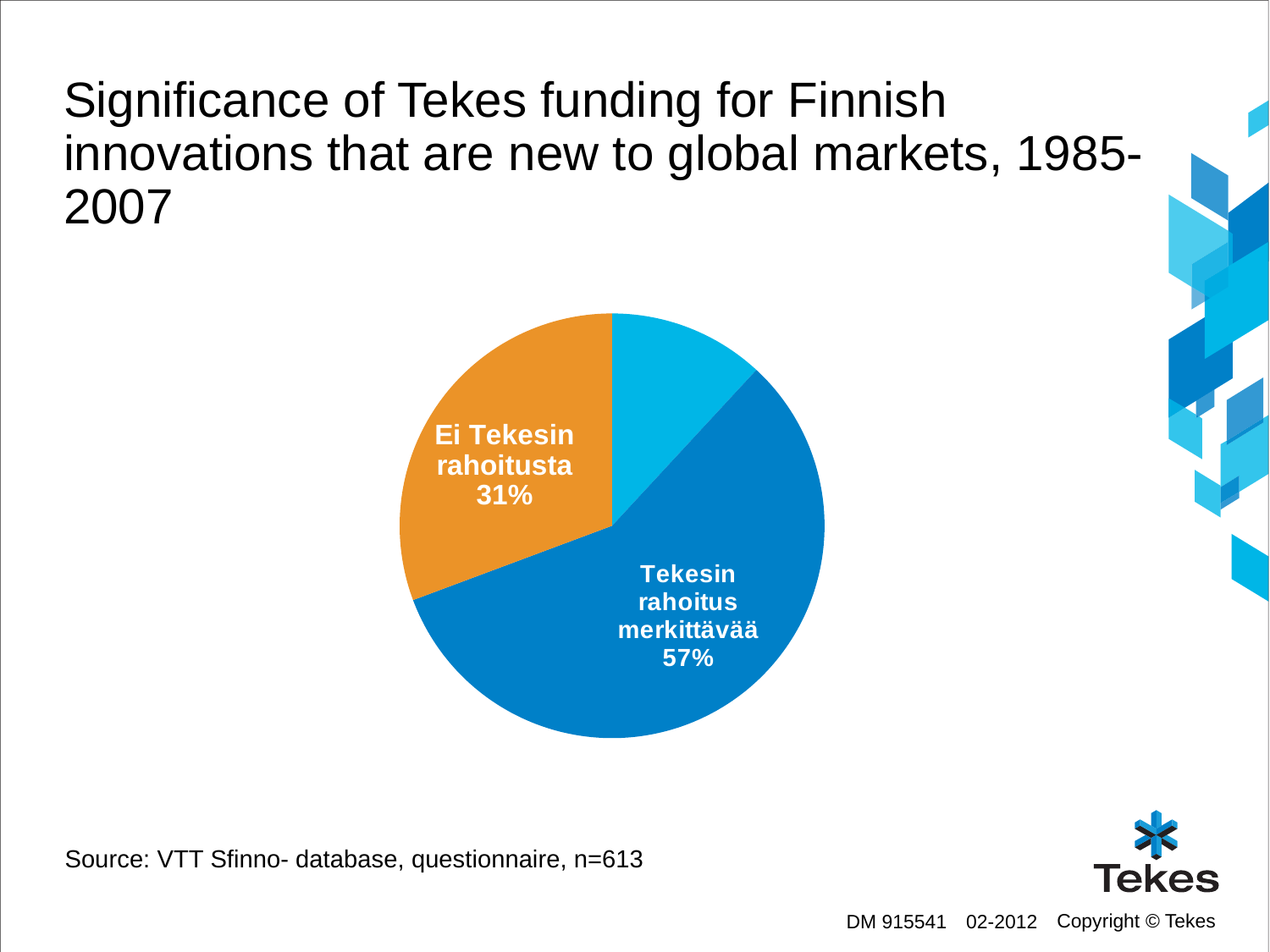
What is the sample size (n) given in the source note below the chart? n=613 What is the difference in percentage points between the "Tekesin rahoitus merkittävää" slice and the "Ei Tekesin rahoitusta" slice? 26 percentage points Which is larger, the share for "Tekesin rahoitus merkittävää" or the share for "Ei Tekesin rahoitusta"? Tekesin rahoitus merkittävää How many slices does the pie chart have? 3 What percentage is shown for the slice labelled "Ei Tekesin rahoitusta"? 31% What kind of chart is shown on the slide? pie chart Which labelled slice of the pie is the largest? Tekesin rahoitus merkittävää What share of the pie does the "Ei Tekesin rahoitusta" slice represent? 31% What colour is the slice labelled "Ei Tekesin rahoitusta"? orange What percentage is shown for the slice labelled "Tekesin rahoitus merkittävää"? 57%